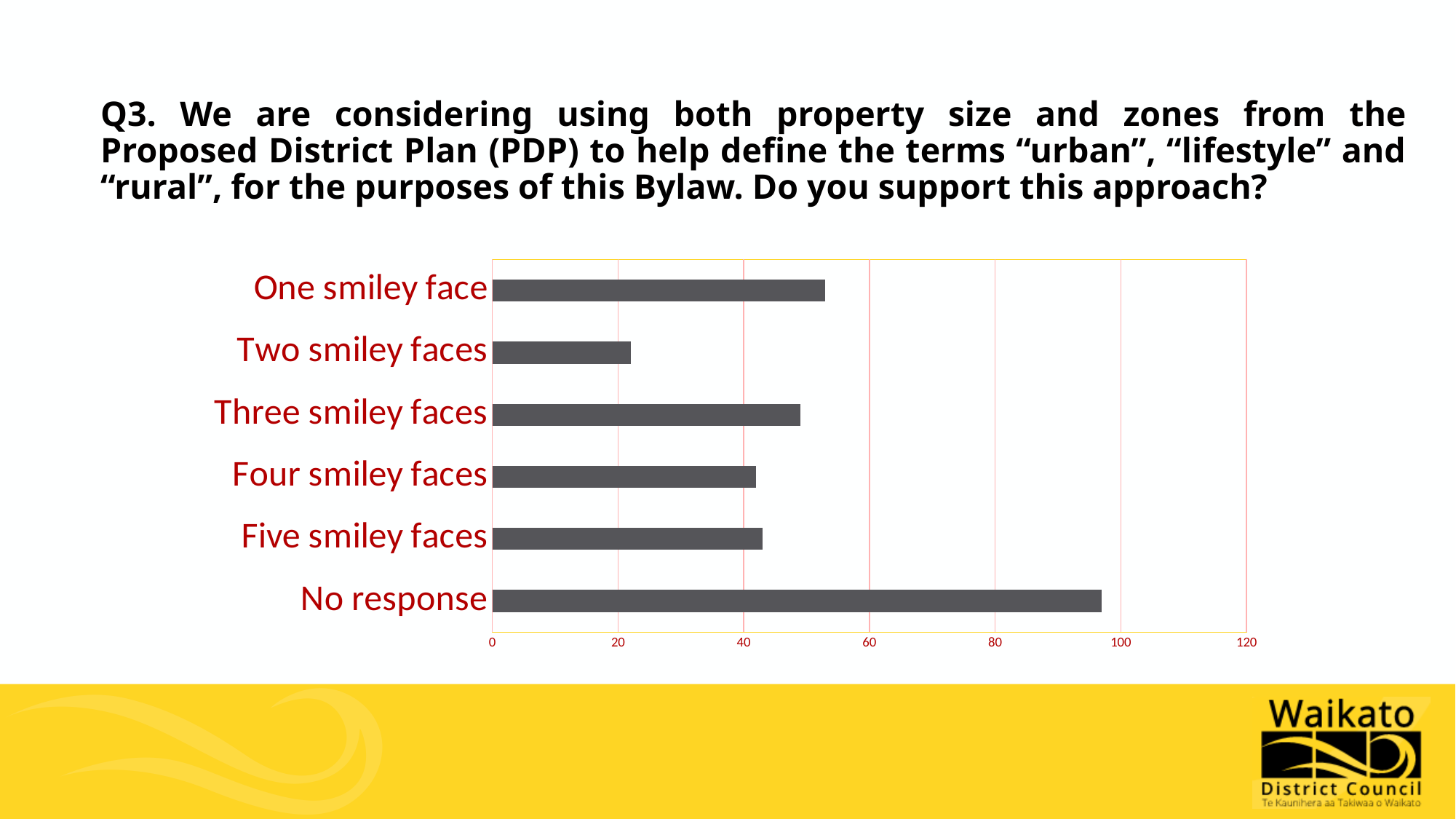
Is the value for Two smiley faces greater or less than 40? less Which is larger, the value for One smiley face or the value for Two smiley faces? One smiley face Which is larger, the value for No response or the value for Three smiley faces? No response What kind of chart is shown on the slide? bar chart What is the highest value shown on the x axis? 120 Is the value for One smiley face greater or less than 40? greater Which category has the lowest value? Two smiley faces How many categories are shown on the chart? 6 Is the value for Three smiley faces greater or less than 60? less Which category has the highest value? No response